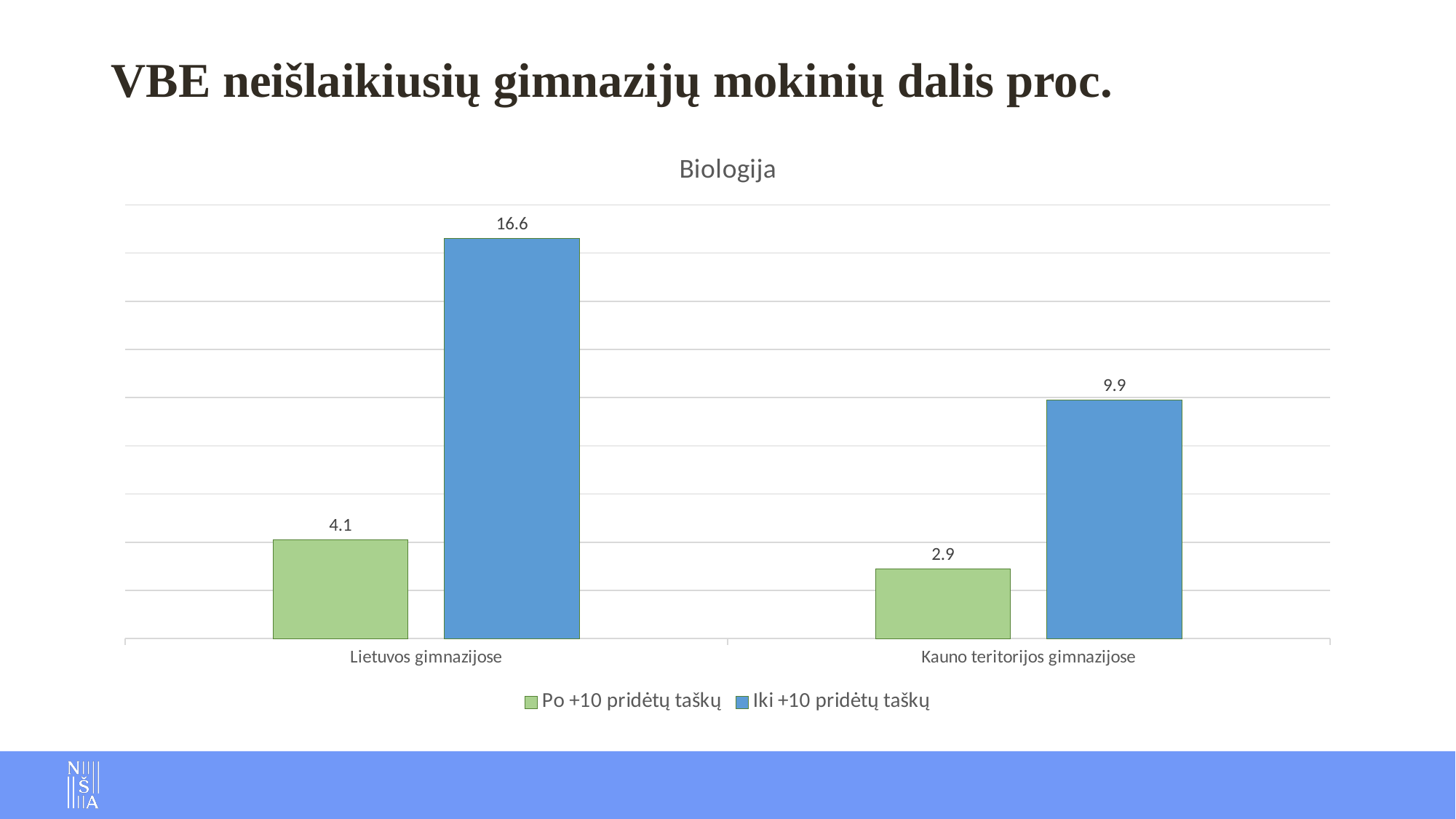
Which is larger: the "Po +10 pridėtų taškų" value for Lietuvos gimnazijose or for Kauno teritorijos gimnazijose? Lietuvos gimnazijose How many categories are shown on the x axis? 2 What is the value for "Po +10 pridėtų taškų" in Kauno teritorijos gimnazijose? 2.9 What is the value for "Iki +10 pridėtų taškų" in Kauno teritorijos gimnazijose? 9.9 What is the value for "Iki +10 pridėtų taškų" in Lietuvos gimnazijose? 16.6 What type of chart is shown on the slide? Bar chart What is the difference between the "Iki +10 pridėtų taškų" and "Po +10 pridėtų taškų" values in Lietuvos gimnazijose? 12.5 Which bar has the highest value on the chart? Iki +10 pridėtų taškų, Lietuvos gimnazijose What is the value for "Po +10 pridėtų taškų" in Lietuvos gimnazijose? 4.1 Which bar has the lowest value on the chart? Po +10 pridėtų taškų, Kauno teritorijos gimnazijose How many series does the legend list? 2 What is the difference between the "Iki +10 pridėtų taškų" values for Lietuvos gimnazijose and Kauno teritorijos gimnazijose? 6.7